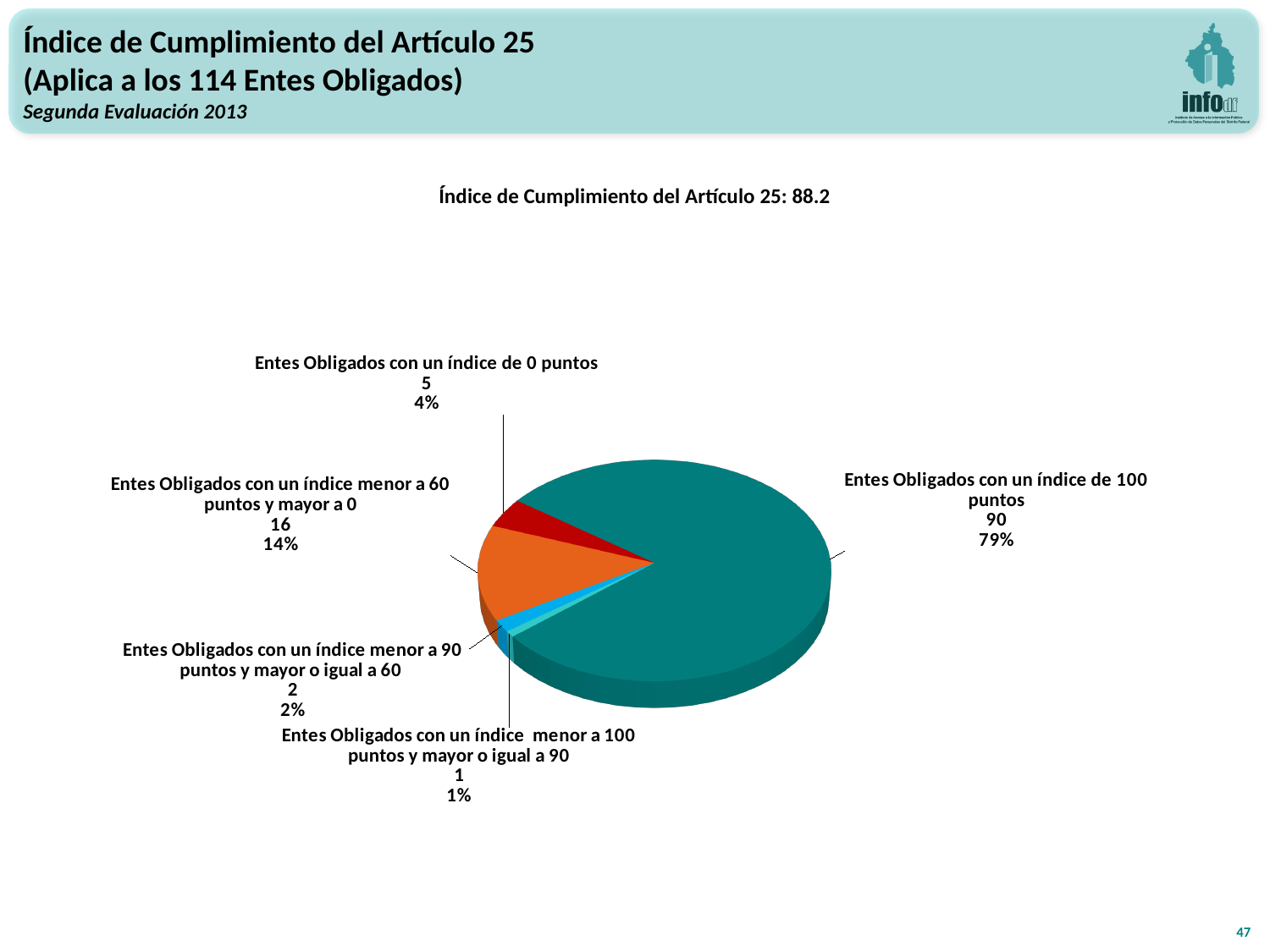
Which category has the smallest slice of the pie? Entes Obligados con un índice menor a 100 puntos y mayor o igual a 90 How many slices does the pie chart have? 5 What percentage of the pie corresponds to Entes Obligados con un índice de 100 puntos? 79% What kind of chart is shown on the slide? Pie chart Which is larger: the number of Entes Obligados with an index of 0 points or those with an index lower than 90 and greater than or equal to 60? Entes Obligados con un índice de 0 puntos How many Entes Obligados have an index of 100 points? 90 How many Entes Obligados have an index lower than 90 points and greater than or equal to 60? 2 What is the Índice de Cumplimiento del Artículo 25 value stated above the chart? 88.2 Which category has the largest slice of the pie? Entes Obligados con un índice de 100 puntos What is the difference between the number of Entes Obligados with an index of 100 points and those with an index lower than 60 and greater than 0? 74 How many Entes Obligados have an index lower than 60 points and greater than 0? 16 What share of the pie is Entes Obligados con un índice de 0 puntos? 4%